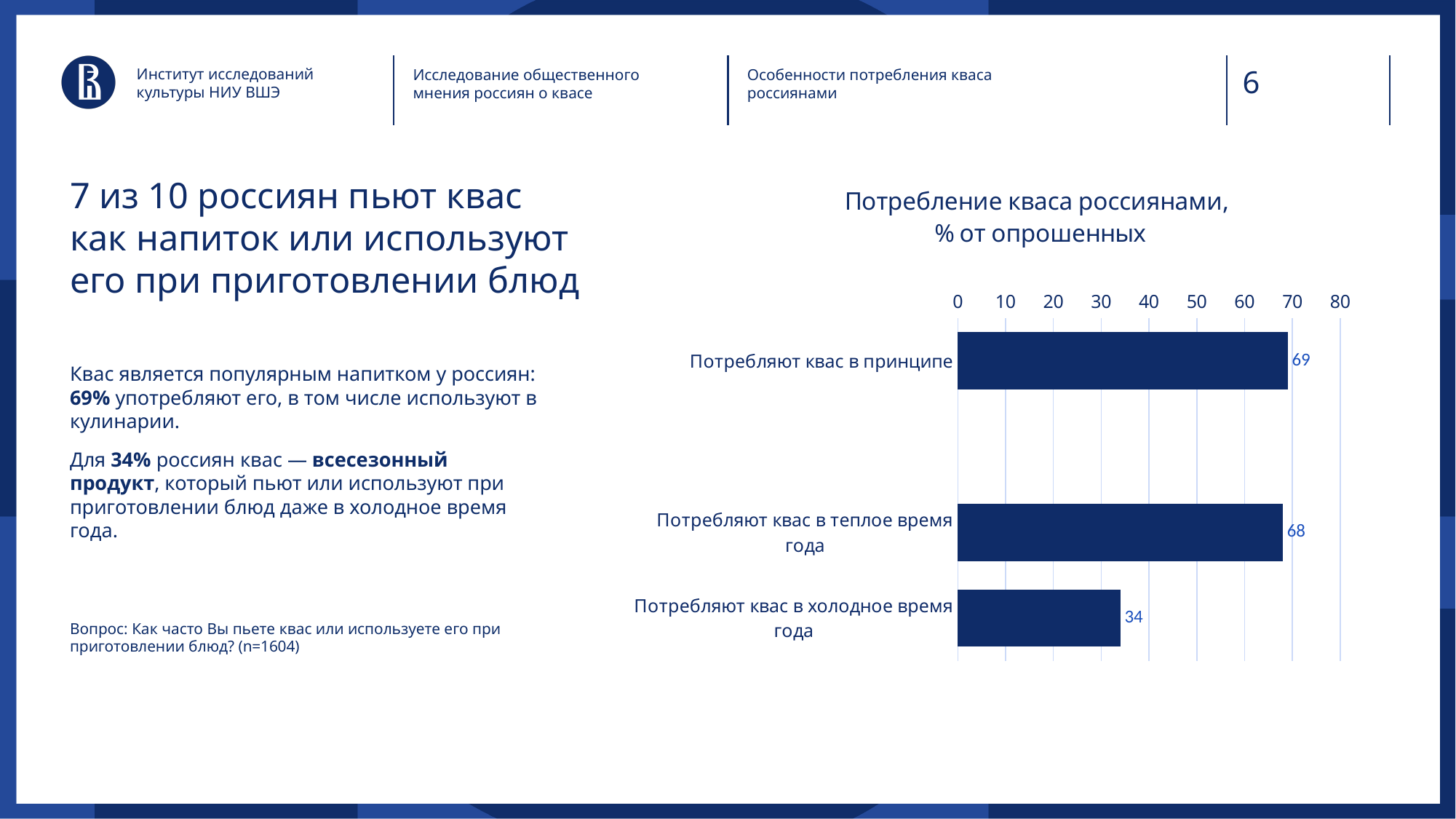
Which category has the lowest value? Потребляют квас в холодное время года What is the difference between the values for "Потребляют квас в теплое время года" and "Потребляют квас в холодное время года"? 34 What is the difference between the values for "Потребляют квас в принципе" and "Потребляют квас в холодное время года"? 35 Which is larger: the value for "Потребляют квас в теплое время года" or "Потребляют квас в холодное время года"? Потребляют квас в теплое время года What is the title of the chart? Потребление кваса россиянами, % от опрошенных What kind of chart is shown on the slide? bar chart How many categories are shown in the chart? 3 Is the value for "Потребляют квас в холодное время года" greater or less than 40? less What value is shown for "Потребляют квас в принципе"? 69 What value is shown for "Потребляют квас в теплое время года"? 68 What value is shown for "Потребляют квас в холодное время года"? 34 Which category has the highest value? Потребляют квас в принципе